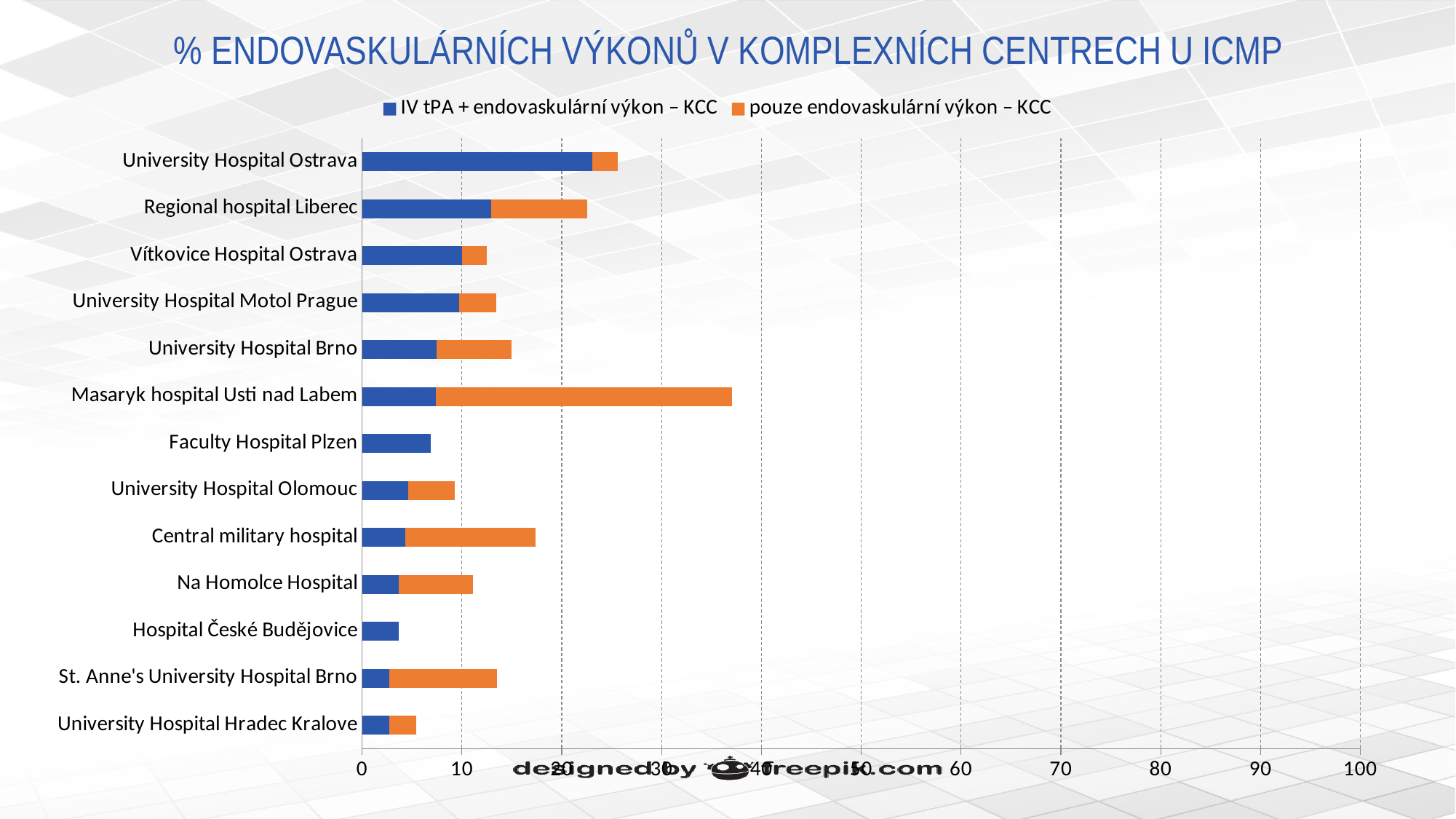
Is the total bar for Masaryk hospital Usti nad Labem greater or less than 30? greater Which hospital has the shortest total bar? Hospital České Budějovice Which hospital has the longest total bar? Masaryk hospital Usti nad Labem How many hospitals are listed on the vertical axis of the chart? 13 What is the title of the chart? % ENDOVASKULÁRNÍCH VÝKONŮ V KOMPLEXNÍCH CENTRECH U ICMP Which series is shown in orange according to the legend? pouze endovaskulární výkon – KCC Which has the longer total bar, Regional hospital Liberec or Vítkovice Hospital Ostrava? Regional hospital Liberec Is the total bar for Faculty Hospital Plzen greater or less than 10? less Is the total bar for Central military hospital greater or less than 20? less Which hospital has the longest blue (IV tPA + endovaskulární výkon – KCC) segment? University Hospital Ostrava How many series does the legend list? 2 What kind of chart is shown on the slide? Stacked bar chart